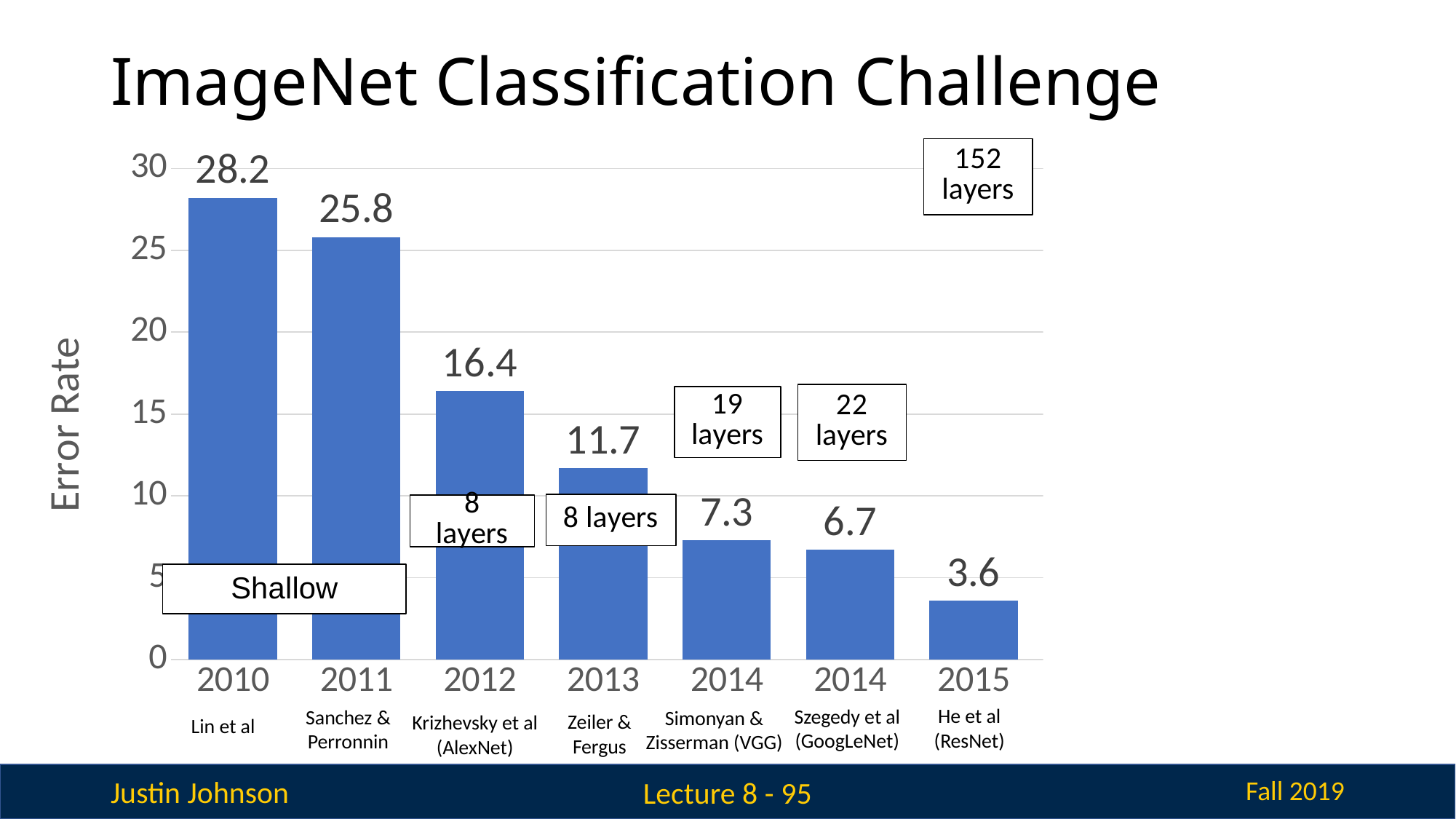
What type of chart is shown on the slide? Bar chart What is the difference in error rate between Lin et al (2010) and Sanchez & Perronnin (2011)? 2.4 What is the error rate for Krizhevsky et al (AlexNet) in 2012? 16.4 Which has a higher error rate, Simonyan & Zisserman (VGG) or Szegedy et al (GoogLeNet)? Simonyan & Zisserman (VGG) Which entry has the lowest error rate? 2015 (He et al, ResNet) Do the error rates rise or fall from 2010 to 2015? Fall What is the difference in error rate between Zeiler & Fergus (2013) and Szegedy et al (GoogLeNet)? 5 Is the error rate for Zeiler & Fergus (2013) greater or less than 10? greater What is the error rate for He et al (ResNet) in 2015? 3.6 What is the error rate for Simonyan & Zisserman (VGG)? 7.3 How many bars are shown in the chart? 7 Which entry has the highest error rate? 2010 (Lin et al)